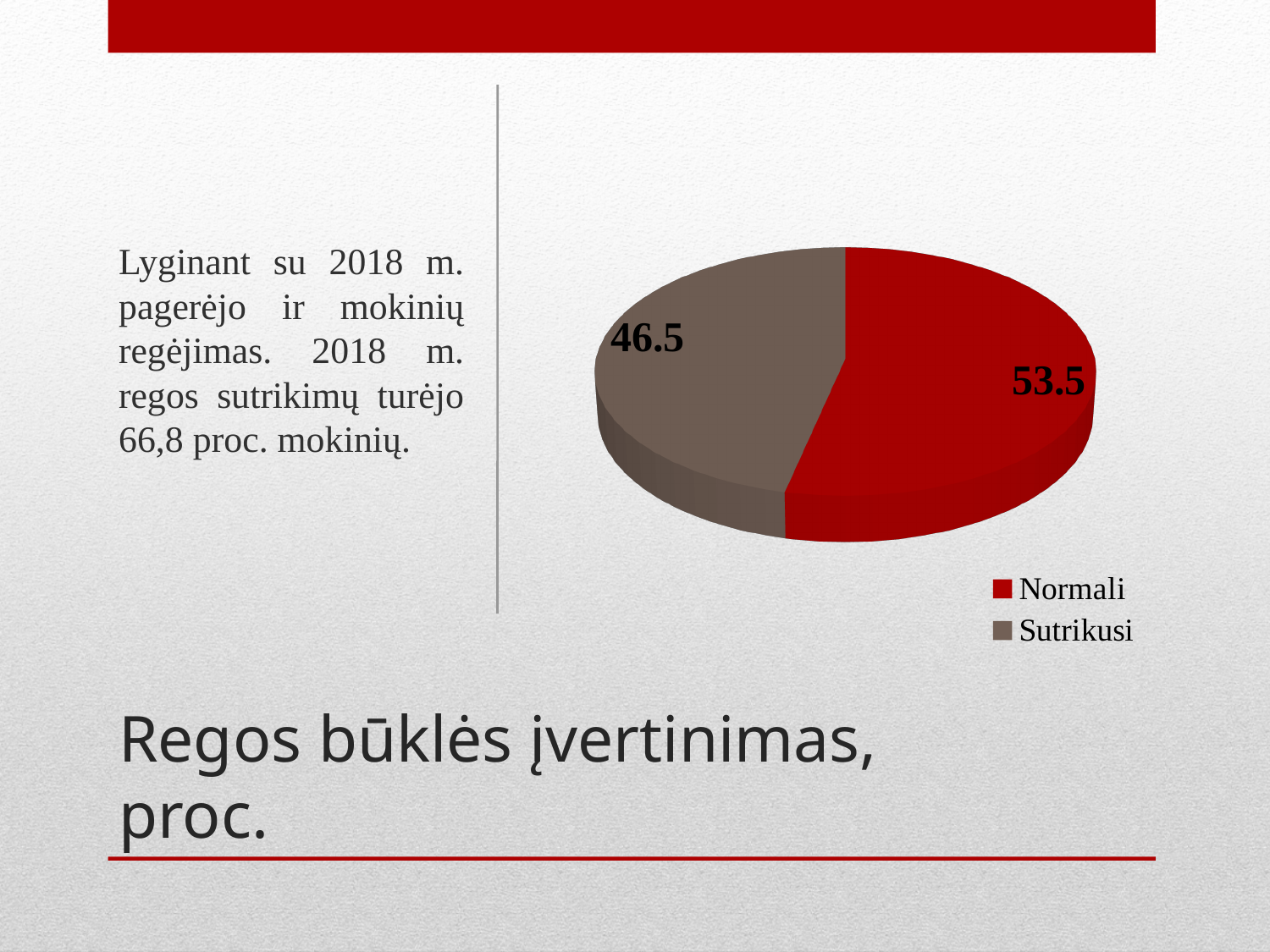
Which colour represents Sutrikusi in the pie chart? Grey-brown What is the total of the two values shown in the pie chart? 100 What type of chart is shown on the slide? Pie chart What value is shown for the Sutrikusi slice of the pie chart? 46.5 Which slice of the pie chart is the smallest? Sutrikusi How many slices does the pie chart have? 2 What value is shown for the Normali slice of the pie chart? 53.5 Which slice of the pie chart is the largest? Normali Which colour represents Normali in the pie chart? Red What is the difference between the Normali and Sutrikusi values in the pie chart? 7 Which is larger in the pie chart, Normali or Sutrikusi? Normali How many entries does the legend of the pie chart list? 2